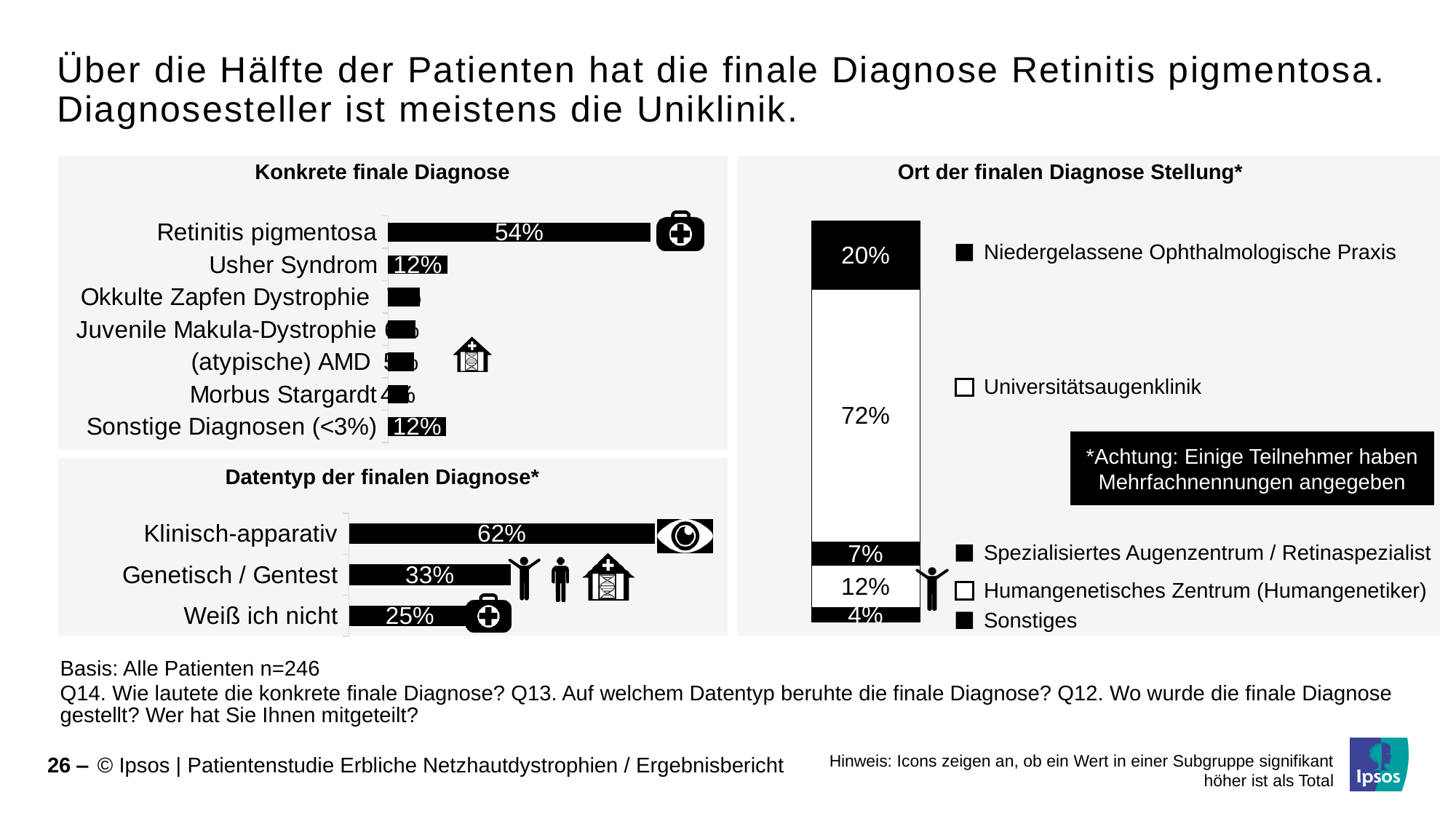
In the 'Datentyp der finalen Diagnose*' chart, what percentage is shown for Klinisch-apparativ? 62% What type of chart is the 'Datentyp der finalen Diagnose*' chart? Bar chart In the 'Konkrete finale Diagnose' chart, what percentage is shown for Retinitis pigmentosa? 54% In the 'Konkrete finale Diagnose' chart, which is larger: Usher Syndrom or Okkulte Zapfen Dystrophie? Usher Syndrom In the 'Ort der finalen Diagnose Stellung*' chart, what is the difference between Universitätsaugenklinik and Humangenetisches Zentrum (Humangenetiker)? 60 percentage points How many entries does the legend of the 'Ort der finalen Diagnose Stellung*' chart list? 5 How many diagnosis categories are listed in the 'Konkrete finale Diagnose' chart? 7 In the 'Ort der finalen Diagnose Stellung*' chart, what percentage is shown for Niedergelassene Ophthalmologische Praxis? 20% In the 'Ort der finalen Diagnose Stellung*' chart, what percentage is shown for Universitätsaugenklinik? 72% In the 'Konkrete finale Diagnose' chart, which diagnosis has the highest value? Retinitis pigmentosa In the 'Datentyp der finalen Diagnose*' chart, what is the difference between Klinisch-apparativ and Genetisch / Gentest? 29 percentage points In the 'Datentyp der finalen Diagnose*' chart, which category has the lowest value? Weiß ich nicht